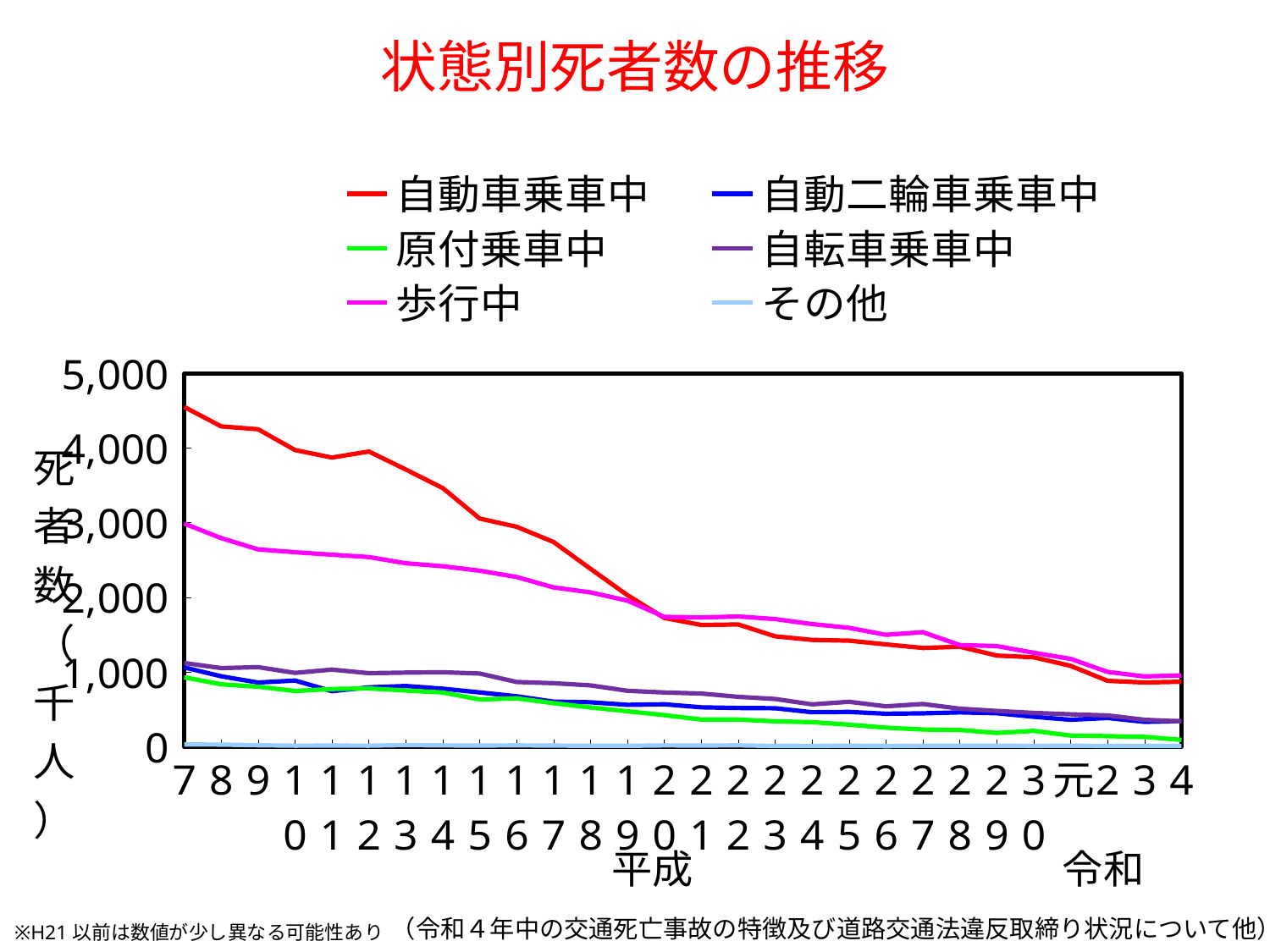
Does the value for 自動車乗車中 rise or fall from 平成7 to 令和4? fall What kind of chart is shown on the slide? line chart Is the value for 原付乗車中 at 令和4 greater or less than 1,000? less What is the title of the chart? 状態別死者数の推移 Which series has the lowest values across the whole period? その他 Does the value for 歩行中 rise or fall from 平成7 to 令和4? fall Is the value for 自動車乗車中 at 平成20 greater or less than 2,000? less Which series has the highest value at 平成7? 自動車乗車中 How many series does the legend list? 6 Which series is drawn in red? 自動車乗車中 Is the value for 自動車乗車中 at 平成7 greater or less than 4,000? greater At 平成7, which is larger: 自動車乗車中 or 歩行中? 自動車乗車中